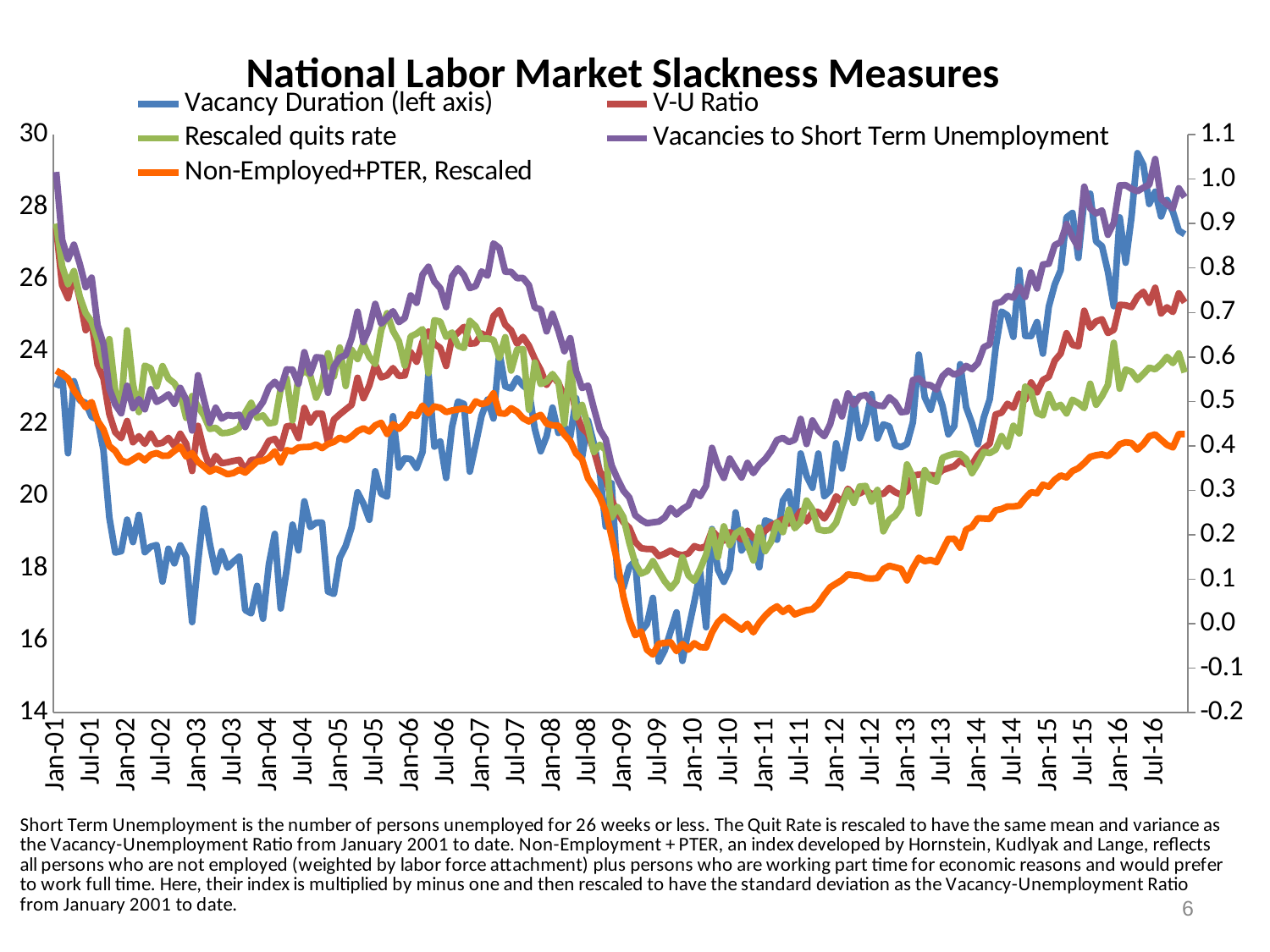
Is the value of Vacancy Duration (left axis) at Jan-16 greater or less than 26? greater Which series is plotted against the left axis according to the legend? Vacancy Duration (left axis) How many series does the legend list? 5 Does the Vacancy Duration (left axis) series rise or fall between Jan-01 and Jan-03? Fall Is the value of Vacancies to Short Term Unemployment at Jan-01 greater or less than 0.9? greater What kind of chart is shown on the slide? Line chart At Jul-16, which is higher: Vacancies to Short Term Unemployment or Non-Employed+PTER, Rescaled? Vacancies to Short Term Unemployment Is the value of Vacancy Duration (left axis) at Jul-09 greater or less than 18? less What is the title of the chart? National Labor Market Slackness Measures Does the Non-Employed+PTER, Rescaled series rise or fall between Jan-10 and Jul-16? Rise